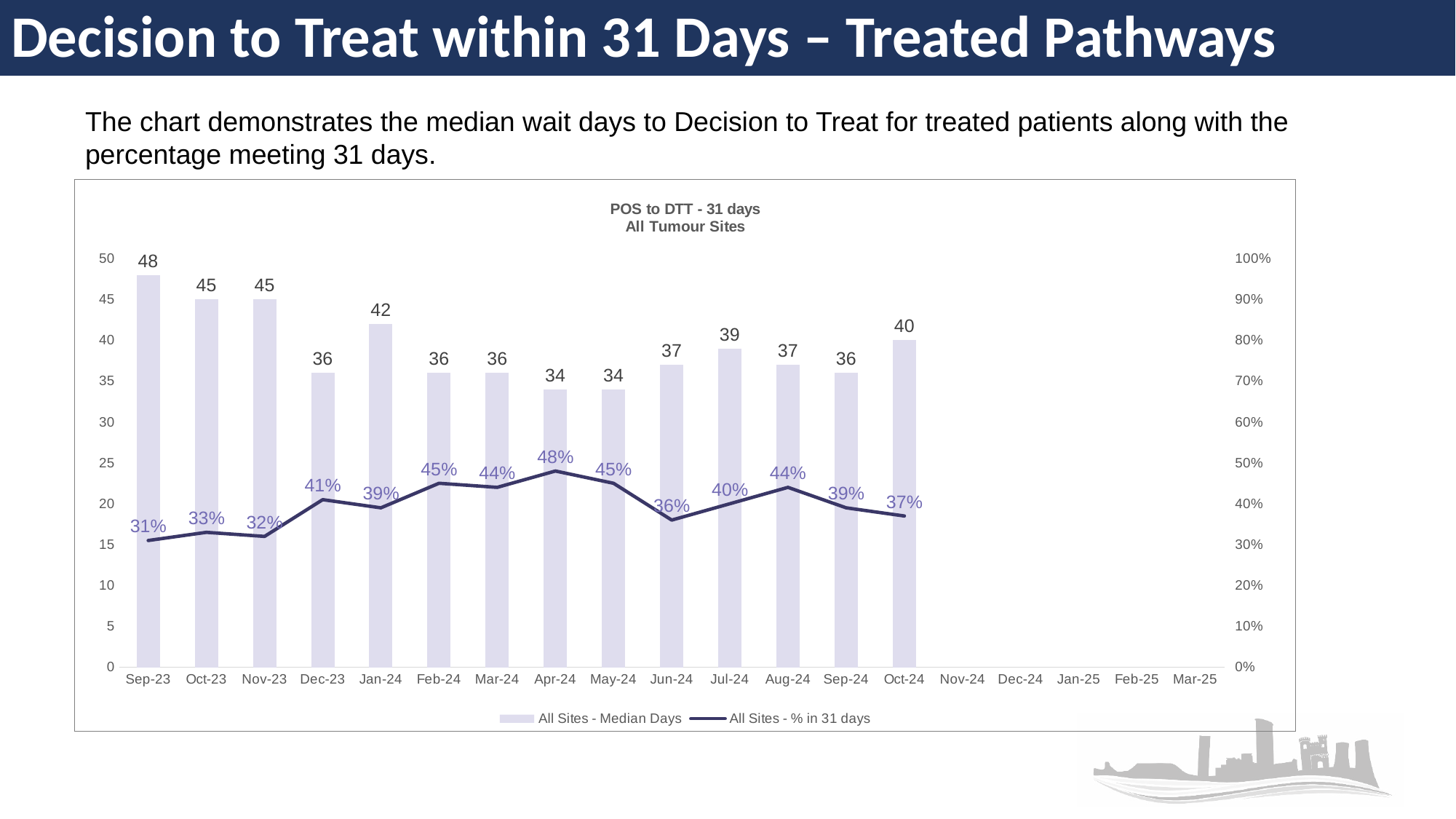
What is the All Sites - Median Days value for Sep-23? 48 What is the All Sites - Median Days value for Oct-24? 40 How many series does the legend list? 2 How many months have a median days bar plotted on the chart? 14 What kind of chart is shown on the slide? Combined bar and line chart Which is larger, the All Sites - % in 31 days value for Jun-24 or for Aug-24? Aug-24 What is the title of the chart? POS to DTT - 31 days All Tumour Sites Does the All Sites - % in 31 days line rise or fall from Sep-23 to Apr-24? Rise What is the difference in All Sites - Median Days between Sep-23 and Oct-24? 8 Which month has the highest All Sites - Median Days value? Sep-23 Which month has the lowest All Sites - % in 31 days value? Sep-23 What is the All Sites - % in 31 days value for Apr-24? 48%